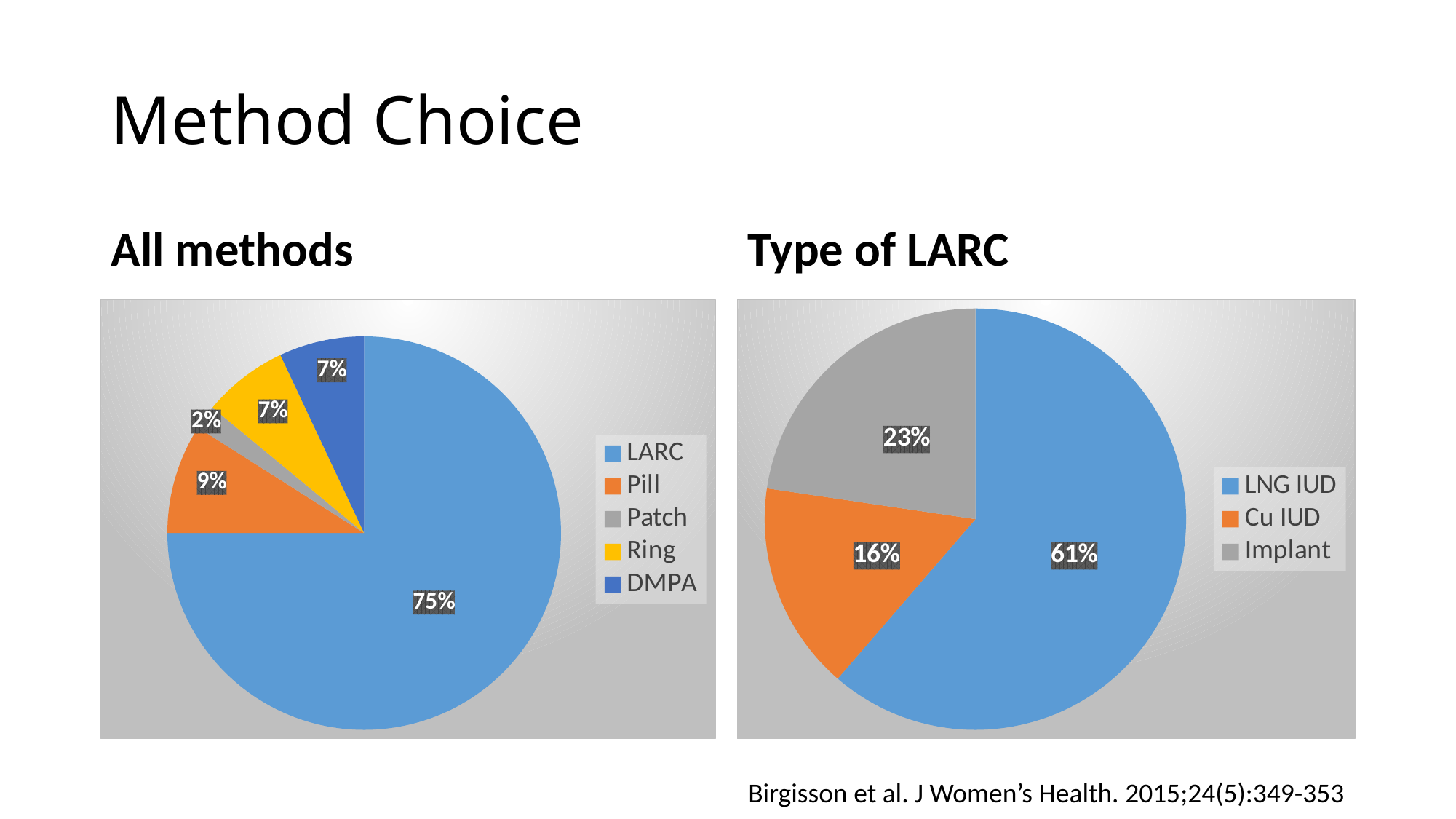
In the 'All methods' chart, what is the difference between the Pill and Patch percentages? 7% In the 'All methods' chart, what percentage is shown for Pill? 9% In the 'Type of LARC' chart, what percentage is shown for Cu IUD? 16% In the 'All methods' chart, what share of the pie is LARC? 75% In the 'All methods' chart, what percentage is shown for Patch? 2% In the 'Type of LARC' chart, what is the difference between the LNG IUD and Implant percentages? 38% In the 'All methods' chart, which category has the largest slice? LARC In the 'All methods' chart, how many categories does the legend list? 5 In the 'All methods' chart, which category has the smallest slice? Patch What kind of chart is the 'Type of LARC' chart? Pie chart In the 'Type of LARC' chart, which is larger, Implant or Cu IUD? Implant In the 'Type of LARC' chart, what share of the pie is LNG IUD? 61%